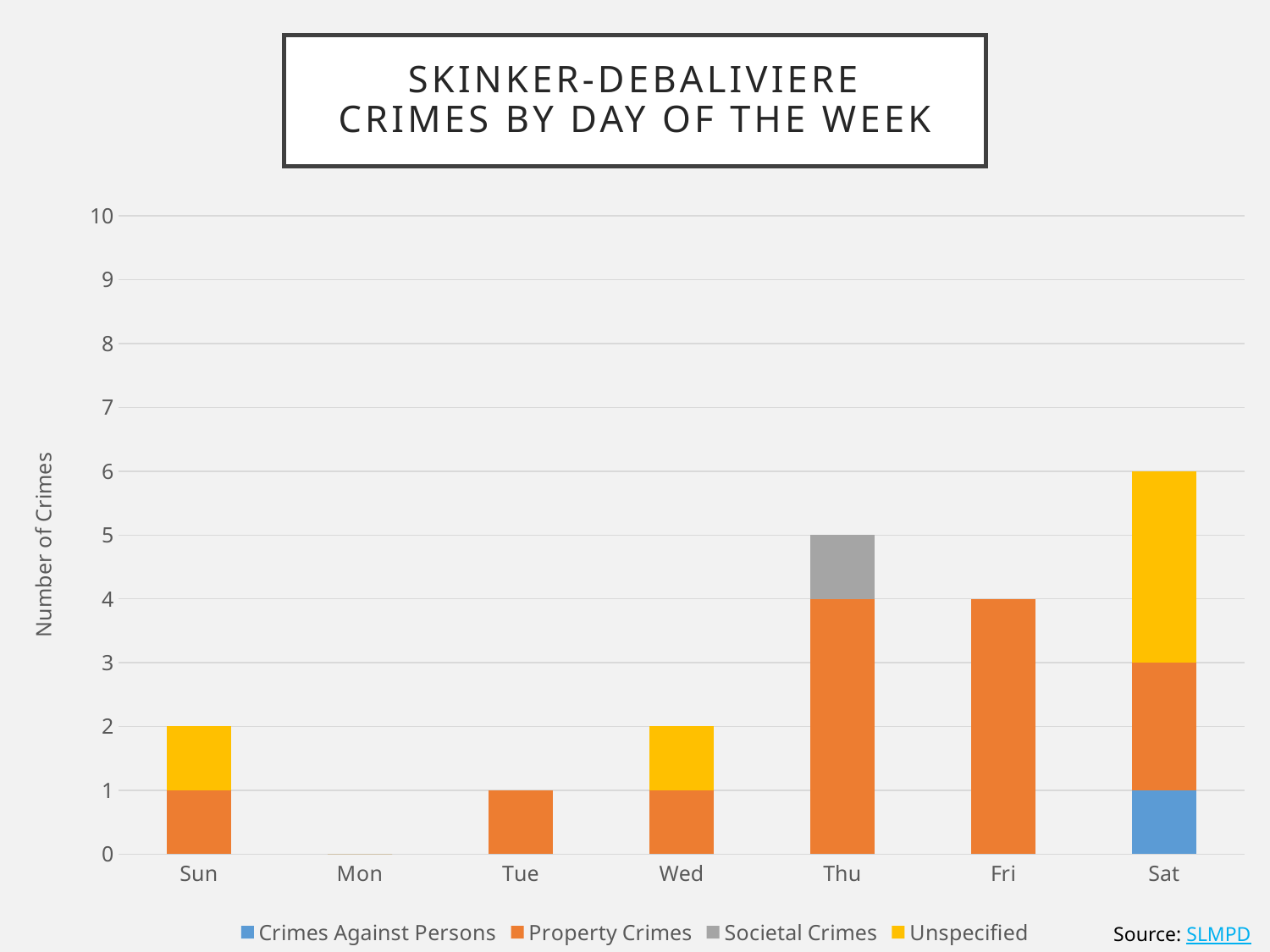
What kind of chart is shown on the slide? Stacked bar chart What is the title of the chart? SKINKER-DEBALIVIERE CRIMES BY DAY OF THE WEEK What is the total number of crimes on Thursday? 5 What is the value for Property Crimes on Friday? 4 What is the total number of crimes on Saturday? 6 What is the difference between the total crimes on Saturday and on Friday? 2 Which has more total crimes, Thursday or Wednesday? Thursday Which day has the lowest total number of crimes? Mon How many series does the legend list? 4 What is the value for Societal Crimes on Thursday? 1 Which day has the highest total number of crimes? Sat How many days of the week are shown on the x axis? 7